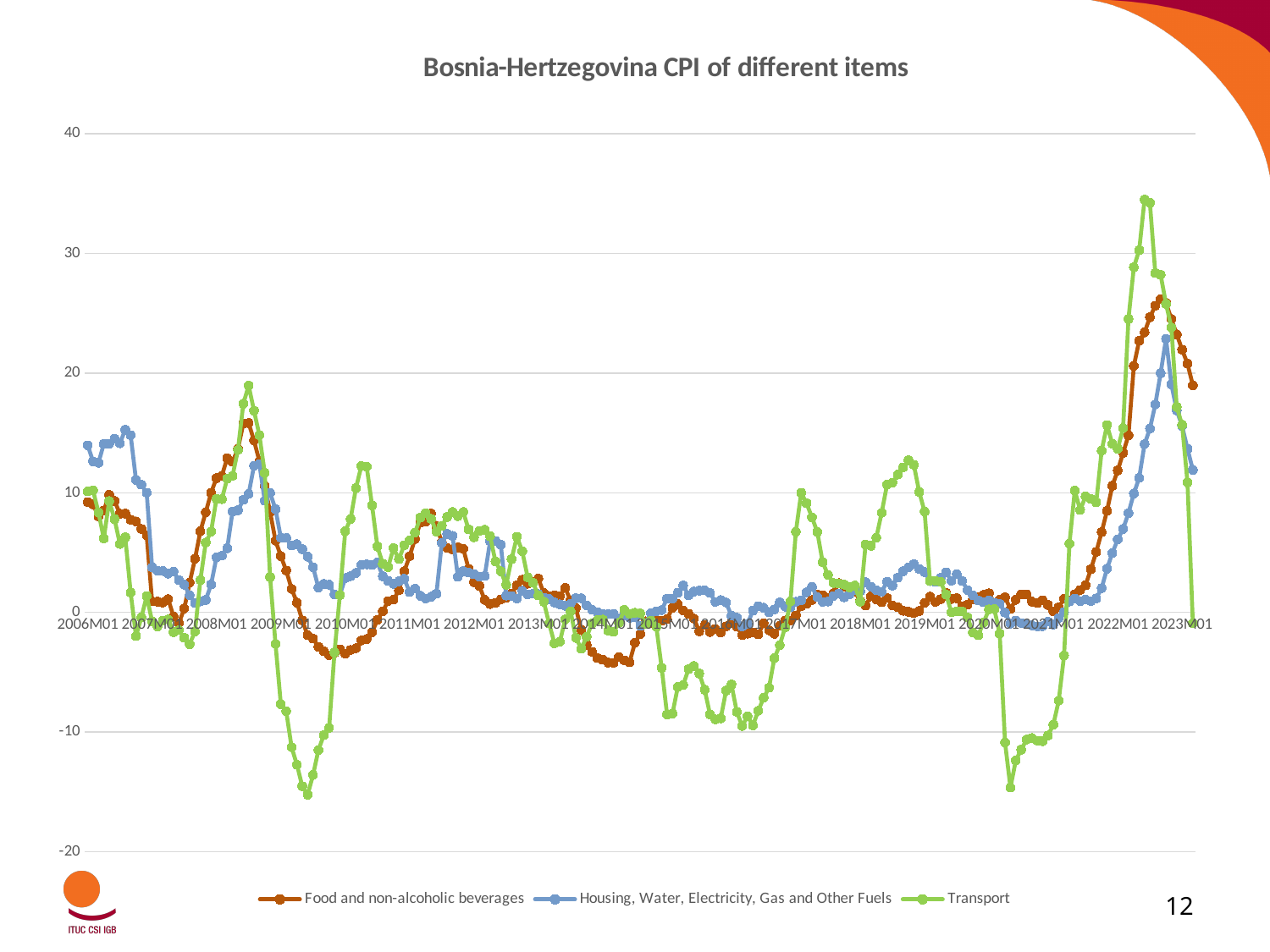
Which series reaches the lowest value on the chart? Transport What kind of chart is shown on the slide? line chart Is the lowest value of the Transport series greater or less than -10? less Does the Food and non-alcoholic beverages series rise or fall between 2021M01 and 2022M01? rise Which colour is used for the Transport series? green What is the title of the chart? Bosnia-Hertzegovina CPI of different items Which series reaches the highest peak on the chart? Transport How many year labels are shown on the x axis? 18 Is the peak value of the Transport series greater or less than 30? greater Is the value for Housing, Water, Electricity, Gas and Other Fuels at 2006M01 greater or less than 10? greater How many series does the legend list? 3